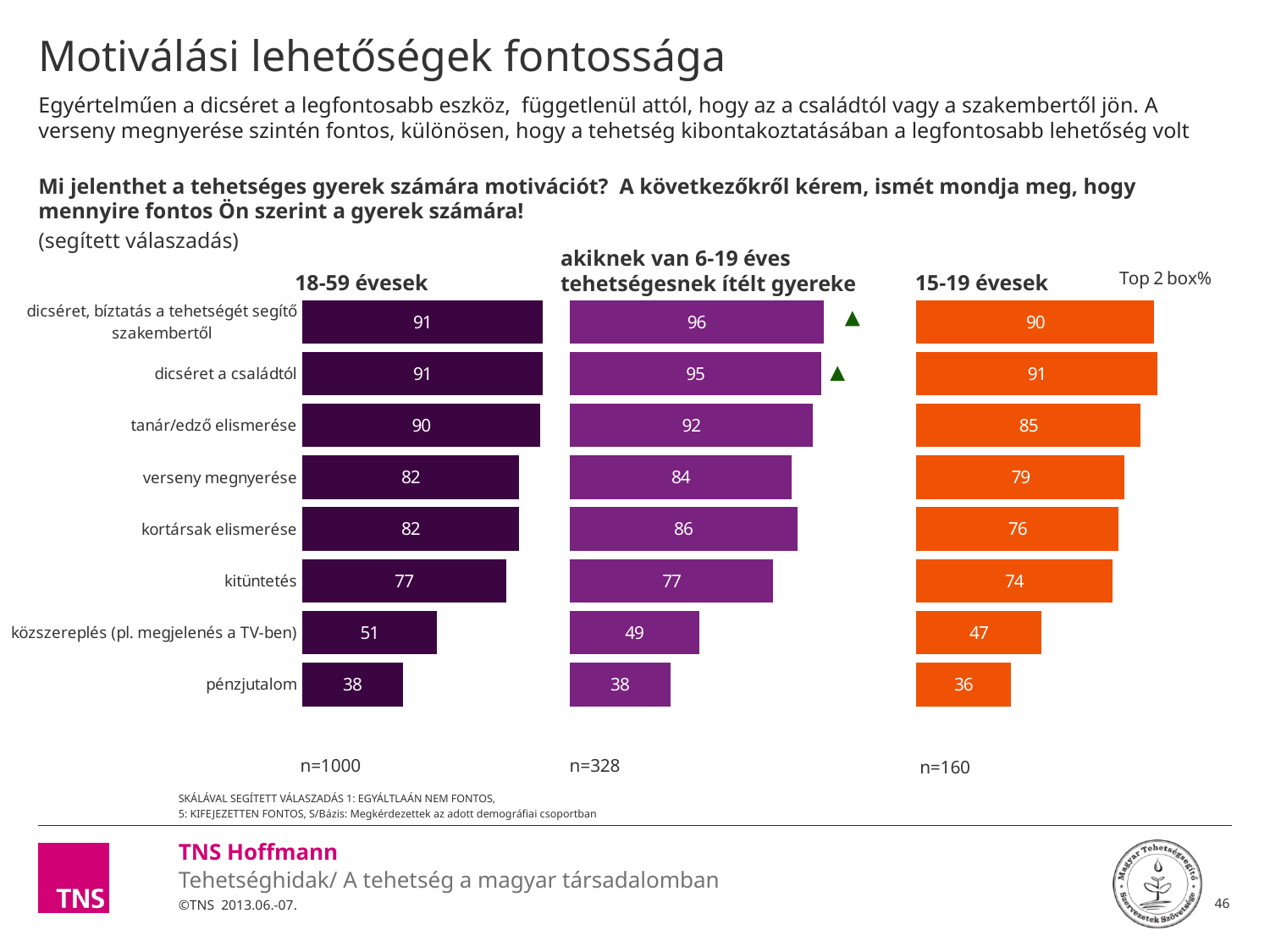
In the "akiknek van 6-19 éves tehetségesnek ítélt gyereke" chart, which is larger: "verseny megnyerése" or "kortársak elismerése"? kortársak elismerése In the "akiknek van 6-19 éves tehetségesnek ítélt gyereke" chart, what is the value for "kortársak elismerése"? 86 In the "15-19 évesek" chart, which is larger: "kitüntetés" or "közszereplés (pl. megjelenés a TV-ben)"? kitüntetés In the "18-59 évesek" chart, what is the difference between the values for "kitüntetés" and "pénzjutalom"? 39 In the "15-19 évesek" chart, what is the value for "pénzjutalom"? 36 In the "15-19 évesek" chart, what is the difference between "tanár/edző elismerése" and "közszereplés (pl. megjelenés a TV-ben)"? 38 How many categories are shown in the "18-59 évesek" chart? 8 In the "15-19 évesek" chart, which category has the lowest value? pénzjutalom In the "18-59 évesek" chart, what is the value for "verseny megnyerése"? 82 What is the sample size (n) shown under the "akiknek van 6-19 éves tehetségesnek ítélt gyereke" chart? n=328 What type of chart is the "15-19 évesek" chart? bar chart In the "akiknek van 6-19 éves tehetségesnek ítélt gyereke" chart, which category has the highest value? dicséret, bíztatás a tehetségét segítő szakembertől